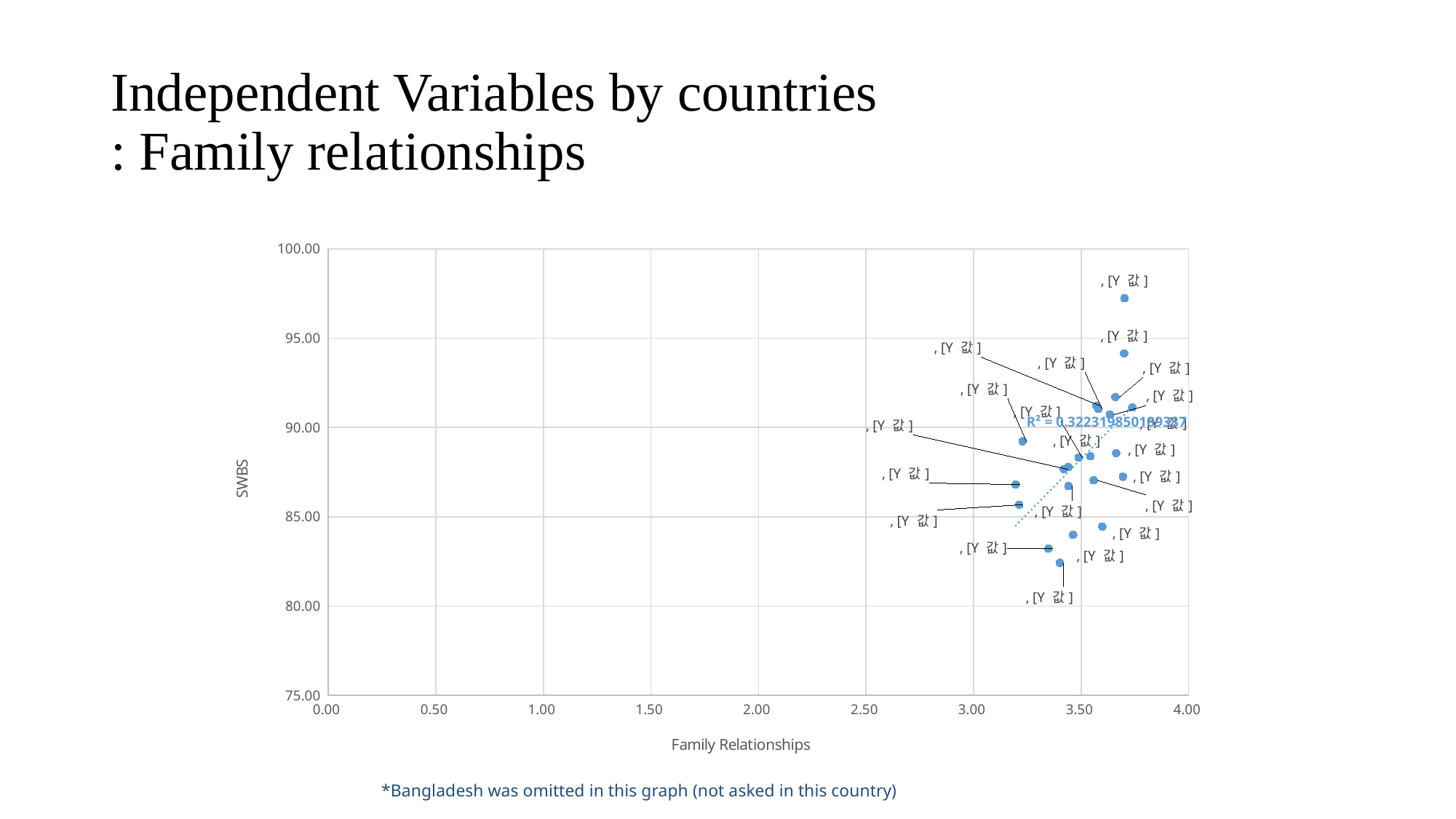
What is the title of the vertical axis? SWBS What kind of chart is shown on the slide? scatter chart Is the SWBS value of the highest point on the chart greater or less than 95.00? greater Do the SWBS values generally rise or fall as Family Relationships increases along the x axis? rise Which country does the footnote say was omitted from the graph? Bangladesh Is the SWBS value of the lowest point on the chart greater or less than 85.00? less Are all the plotted points' Family Relationships values greater or less than 3.00? greater